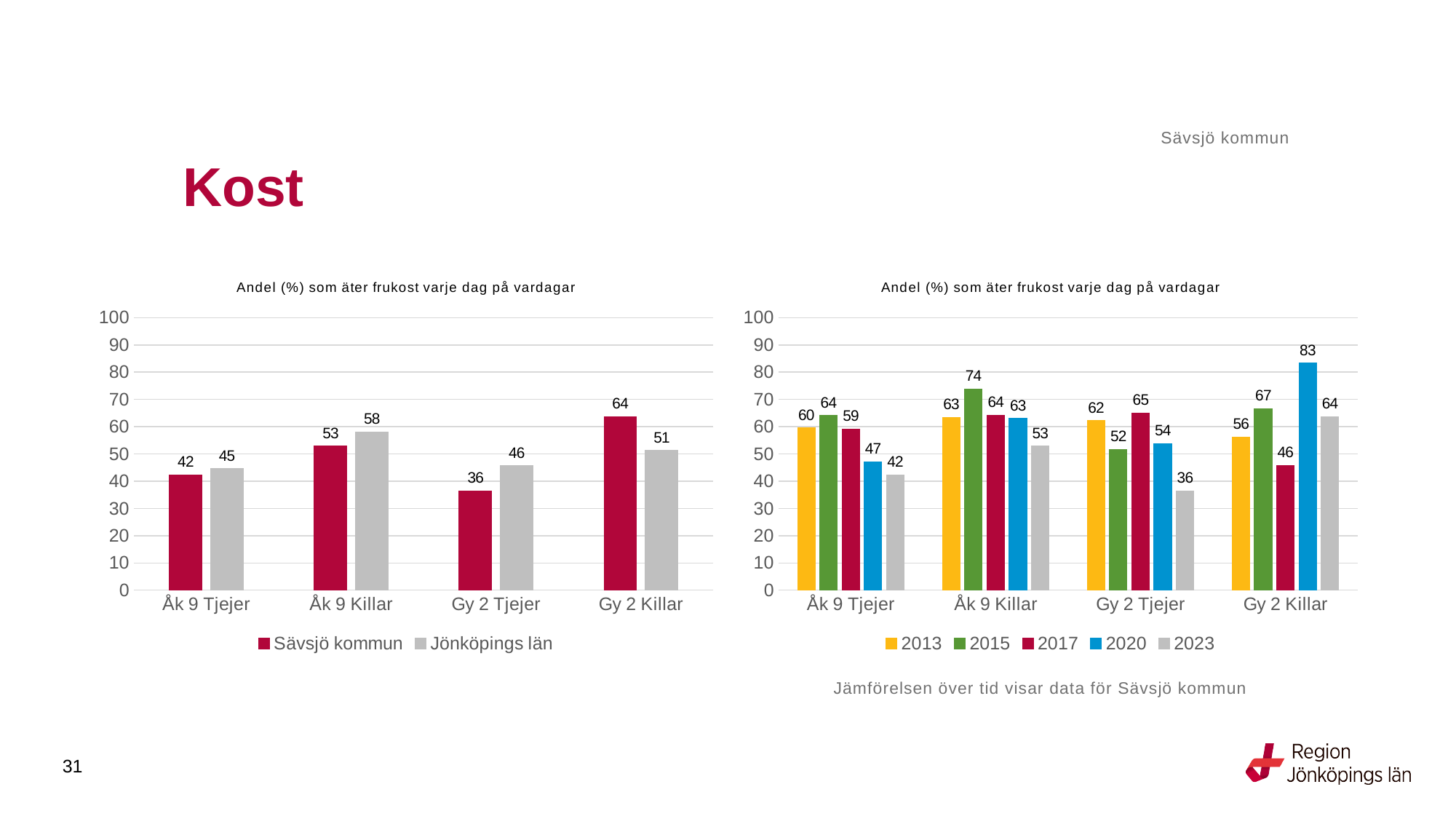
In the left chart, which category has the lowest value for Sävsjö kommun? Gy 2 Tjejer In the left chart, what is the value for Jönköpings län for Åk 9 Killar? 58 In the left chart, what is the value for Sävsjö kommun for Gy 2 Killar? 64 How many series does the legend of the right chart list? 5 In the right chart, what is the value for 2015 for Åk 9 Killar? 74 In the right chart, which year has the highest value for Gy 2 Tjejer? 2017 What kind of chart is the right chart? Bar chart In the left chart, which is larger for Gy 2 Killar: Sävsjö kommun or Jönköpings län? Sävsjö kommun How many series does the legend of the left chart list? 2 In the right chart, what is the difference between the 2020 and 2023 values for Gy 2 Killar? 19 In the right chart, what is the value for 2020 for Gy 2 Killar? 83 In the left chart, what is the difference between Jönköpings län and Sävsjö kommun for Gy 2 Tjejer? 10